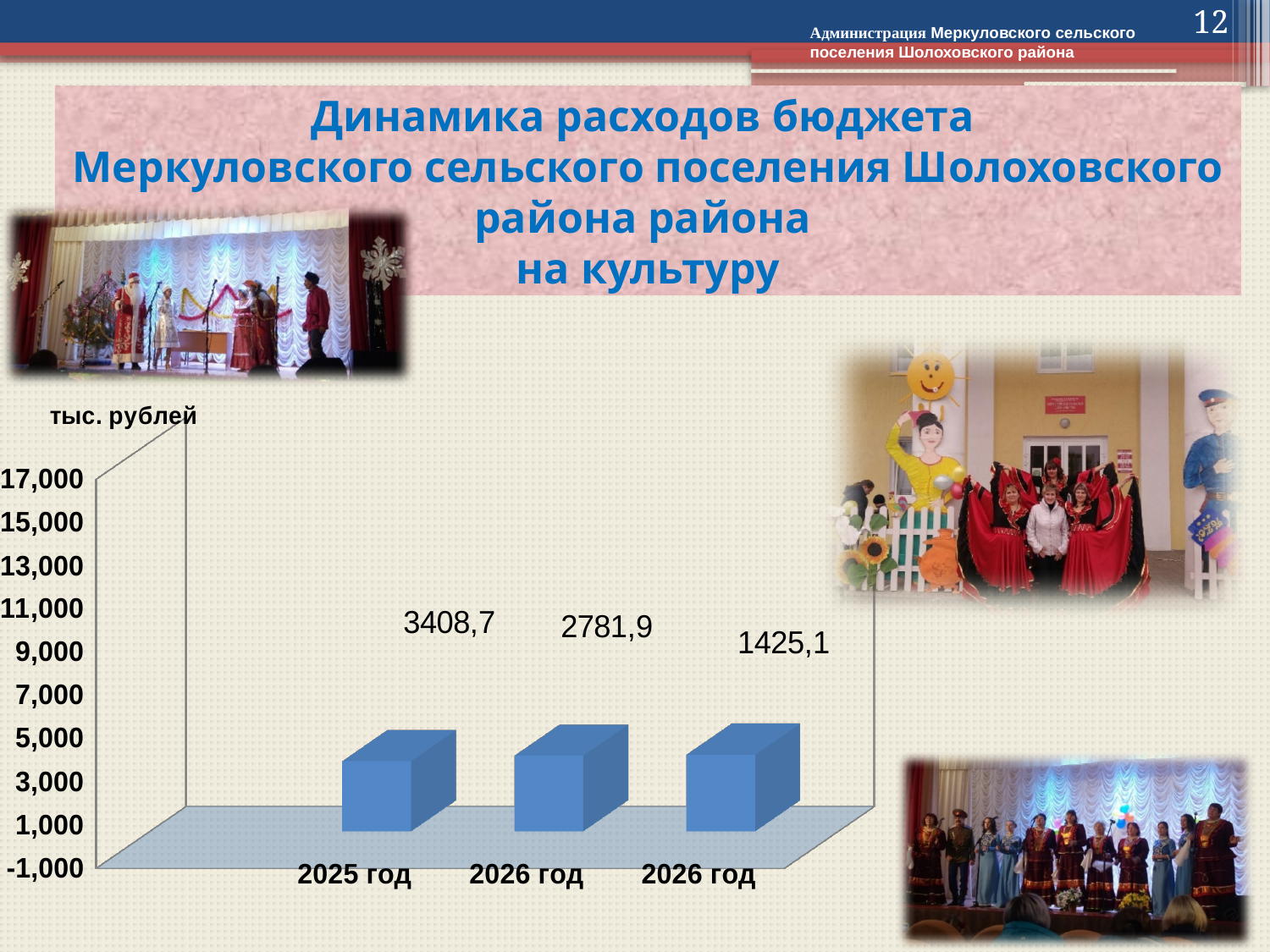
What kind of chart is shown on the slide? bar chart What is the difference between the value for 2025 год and the value on the middle bar? 626,8 What is the difference between the value for 2025 год and the value on the rightmost bar? 1983,6 Is the value for 2025 год greater or less than 3,000? greater What is the value shown on the middle bar of the chart? 2781,9 What is the value for 2025 год? 3408,7 How many bars are plotted on the chart? 3 What is the lowest value shown on the chart? 1425,1 Which is larger, the value on the middle bar or the value on the rightmost bar? the middle bar (2781,9) What is the value shown on the rightmost bar of the chart? 1425,1